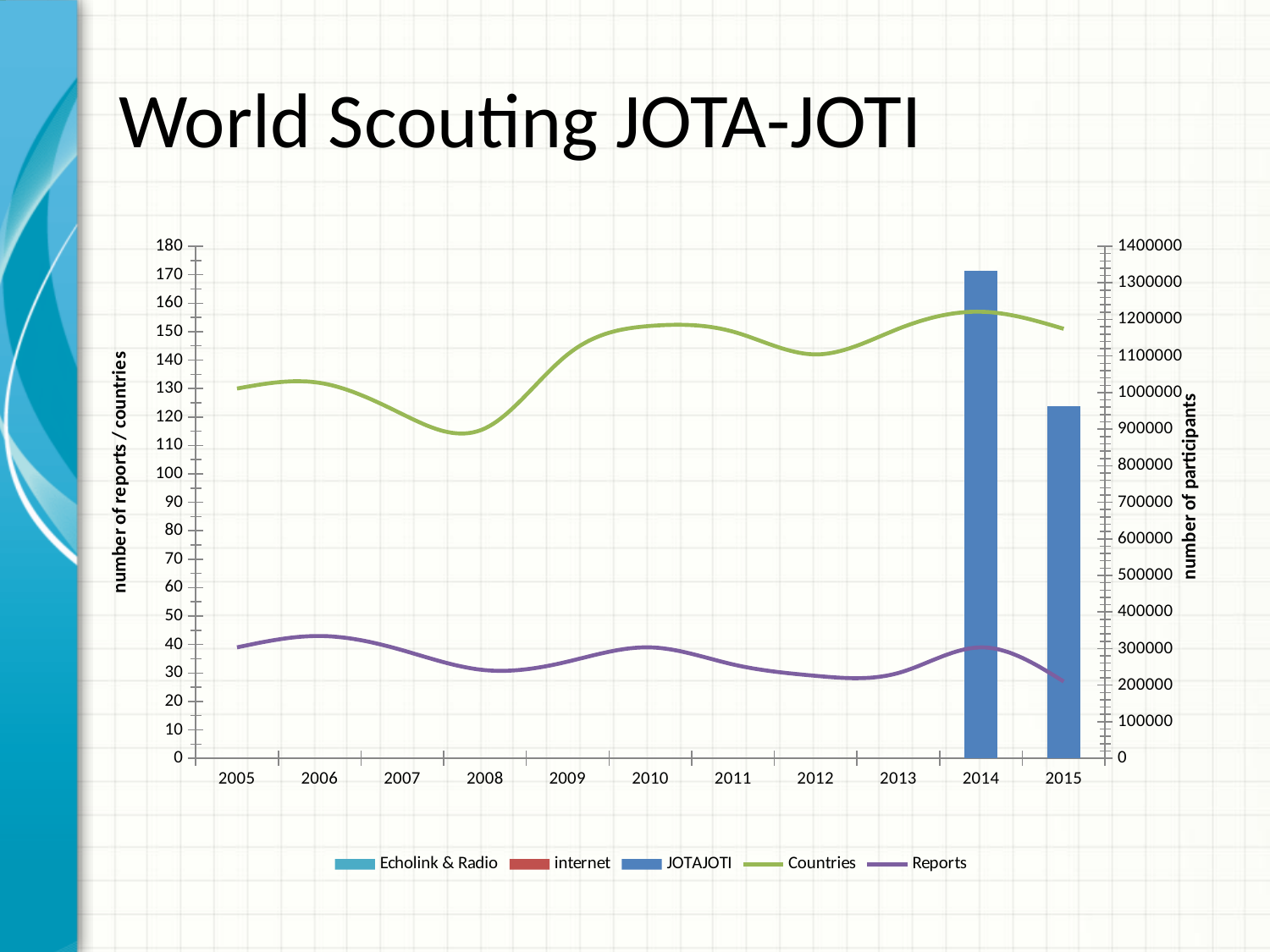
Is the JOTAJOTI value for 2014 greater or less than 1300000? greater Is the JOTAJOTI value for 2015 greater or less than 1000000? less How many series does the legend list? 5 How many years are shown along the x axis? 11 Which year has the taller JOTAJOTI bar, 2014 or 2015? 2014 What kind of chart is shown on the slide? A combination bar and line chart Is the Countries value for 2008 greater or less than 120? less Does the Countries line rise or fall from 2006 to 2008? fall In which year is the Reports line at its highest? 2006 In which year is the Countries line at its lowest? 2008 What is the title of the right-hand vertical axis? number of participants